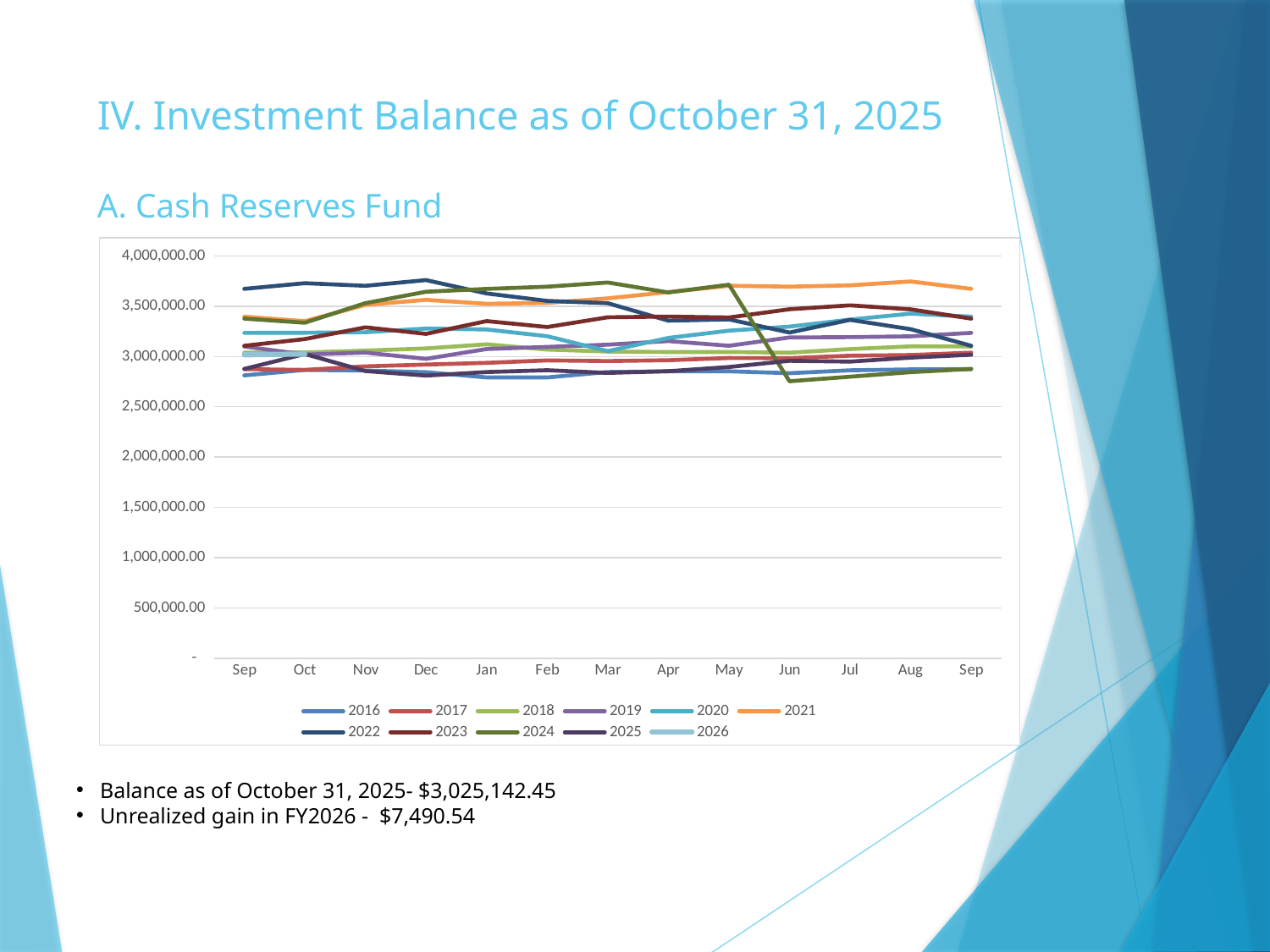
How many series does the legend list? 11 What kind of chart is shown on the slide? Line chart Is the value for 2016 in Sep (the first Sep) greater or less than 3,000,000.00? less Which series has the lowest value in Jun? 2024 Which series has the highest value in Aug? 2021 How many month labels are shown along the x axis? 13 Does the 2024 series rise or fall between May and Jun? Fall What is the highest value labelled on the y axis? 4,000,000.00 Is the value for 2021 in Aug greater or less than 3,500,000.00? greater Is the value for 2022 in Dec greater or less than 3,500,000.00? greater Which is larger in Aug, the value for 2021 or the value for 2016? 2021